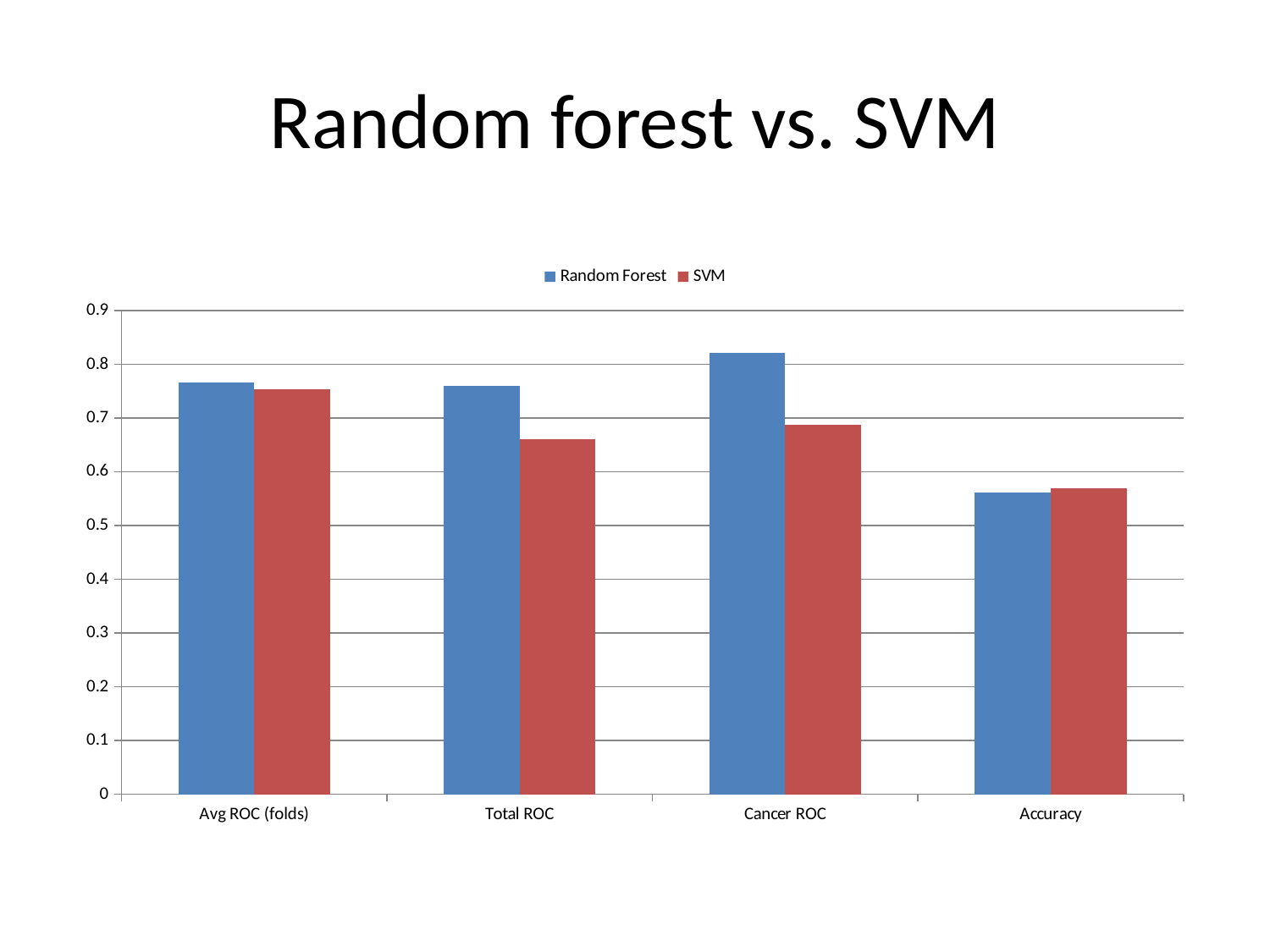
What kind of chart is shown on the slide? Bar chart How many series does the legend list? 2 How many categories are shown on the x axis? 4 Is the SVM value for Cancer ROC greater or less than 0.7? less For which category is the SVM value lowest? Accuracy For Cancer ROC, which series has the larger value, Random Forest or SVM? Random Forest For which category is the Random Forest value lowest? Accuracy Is the Random Forest value for Accuracy greater or less than 0.6? less For Total ROC, which series has the larger value, Random Forest or SVM? Random Forest For which category is the Random Forest value highest? Cancer ROC What is the title of the slide? Random forest vs. SVM Is the Random Forest value for Cancer ROC greater or less than 0.8? greater